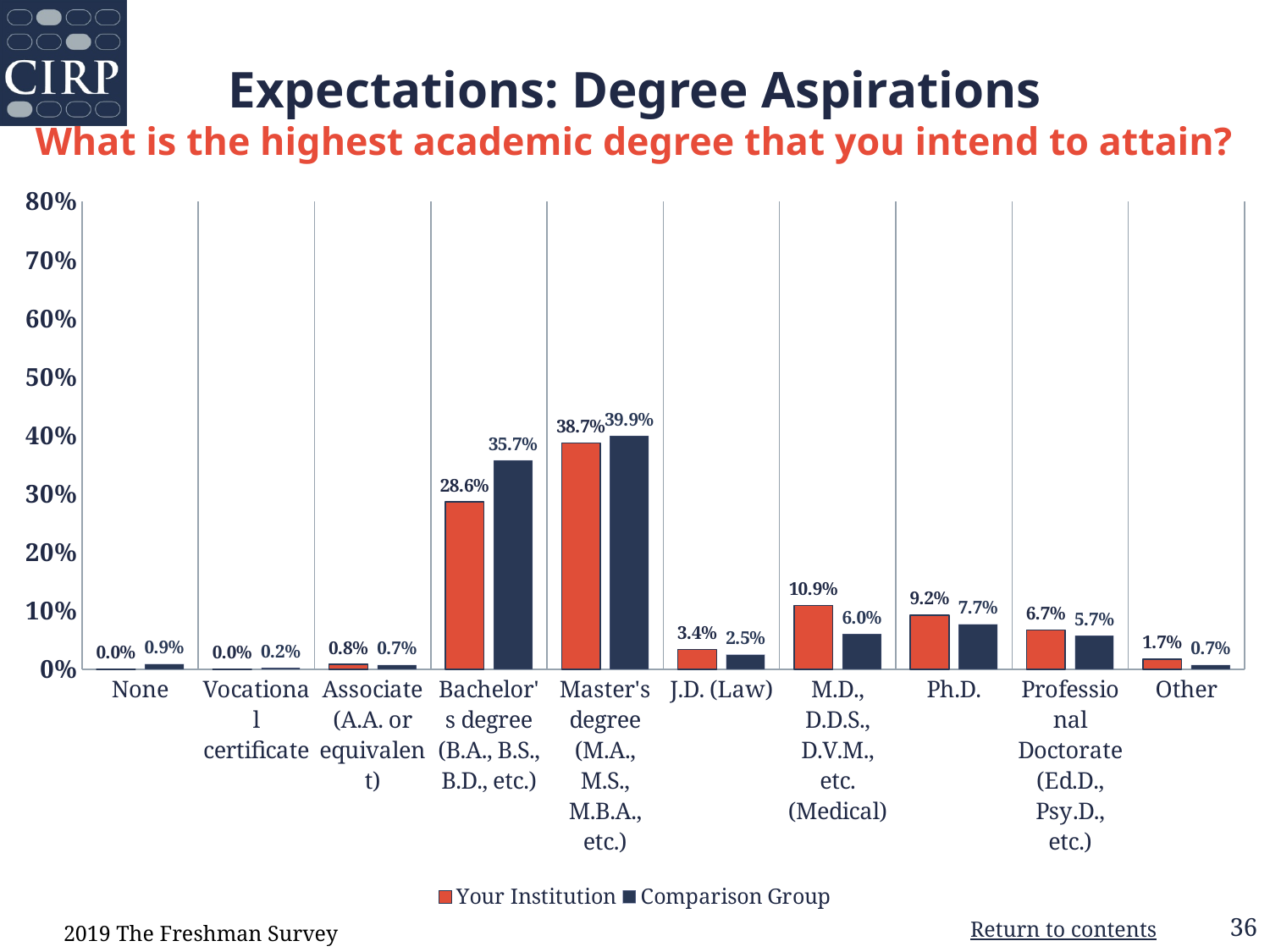
What kind of chart is shown on the slide? Bar chart What is the value for Your Institution for Master's degree (M.A., M.S., M.B.A., etc.)? 38.7% What is the difference between Comparison Group and Your Institution for Bachelor's degree (B.A., B.S., B.D., etc.)? 7.1% How many series does the legend list? 2 Which category has the lowest value for Comparison Group? Vocational certificate What is the value for Your Institution for M.D., D.D.S., D.V.M., etc. (Medical)? 10.9% Which is larger for Ph.D.: Your Institution or Comparison Group? Your Institution How many categories are shown on the x axis? 10 Is the value for Your Institution for Master's degree greater or less than 30%? greater What is the value for Comparison Group for Bachelor's degree (B.A., B.S., B.D., etc.)? 35.7% What colour are the bars for Your Institution? Orange-red Which category has the highest value for Comparison Group? Master's degree (M.A., M.S., M.B.A., etc.)